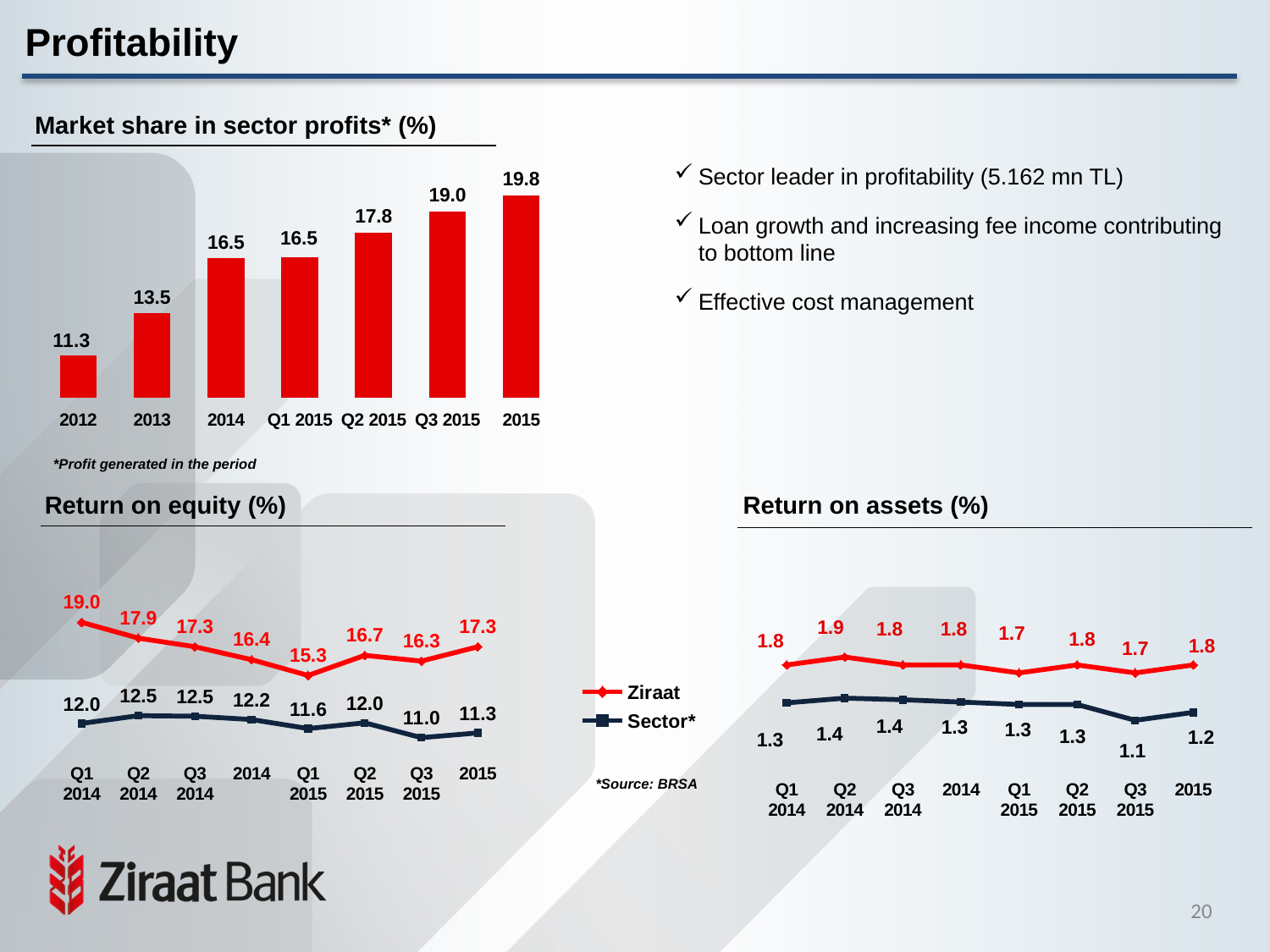
How many series does the legend list for the 'Return on equity' and 'Return on assets' charts? 2 In the 'Market share in sector profits' chart, which category has the highest value? 2015 In the 'Return on equity' chart, what is the difference between the Ziraat and Sector values for 2015? 6.0 In the 'Return on equity' chart, which period has the highest Ziraat value? Q1 2014 In the 'Market share in sector profits' chart, what is the value for 2012? 11.3 In the 'Return on equity' chart, what is the Ziraat value for Q1 2015? 15.3 In the 'Return on assets' chart, which is larger for Q2 2014: the Ziraat value or the Sector value? Ziraat In the 'Return on equity' chart, what is the Sector value for Q3 2015? 11.0 In the 'Market share in sector profits' chart, what is the difference between the 2015 value and the 2012 value? 8.5 What kind of chart is the 'Market share in sector profits' chart? Bar chart In the 'Return on assets' chart, what is the Sector value for Q3 2015? 1.1 How many bars are shown in the 'Market share in sector profits' chart? 7